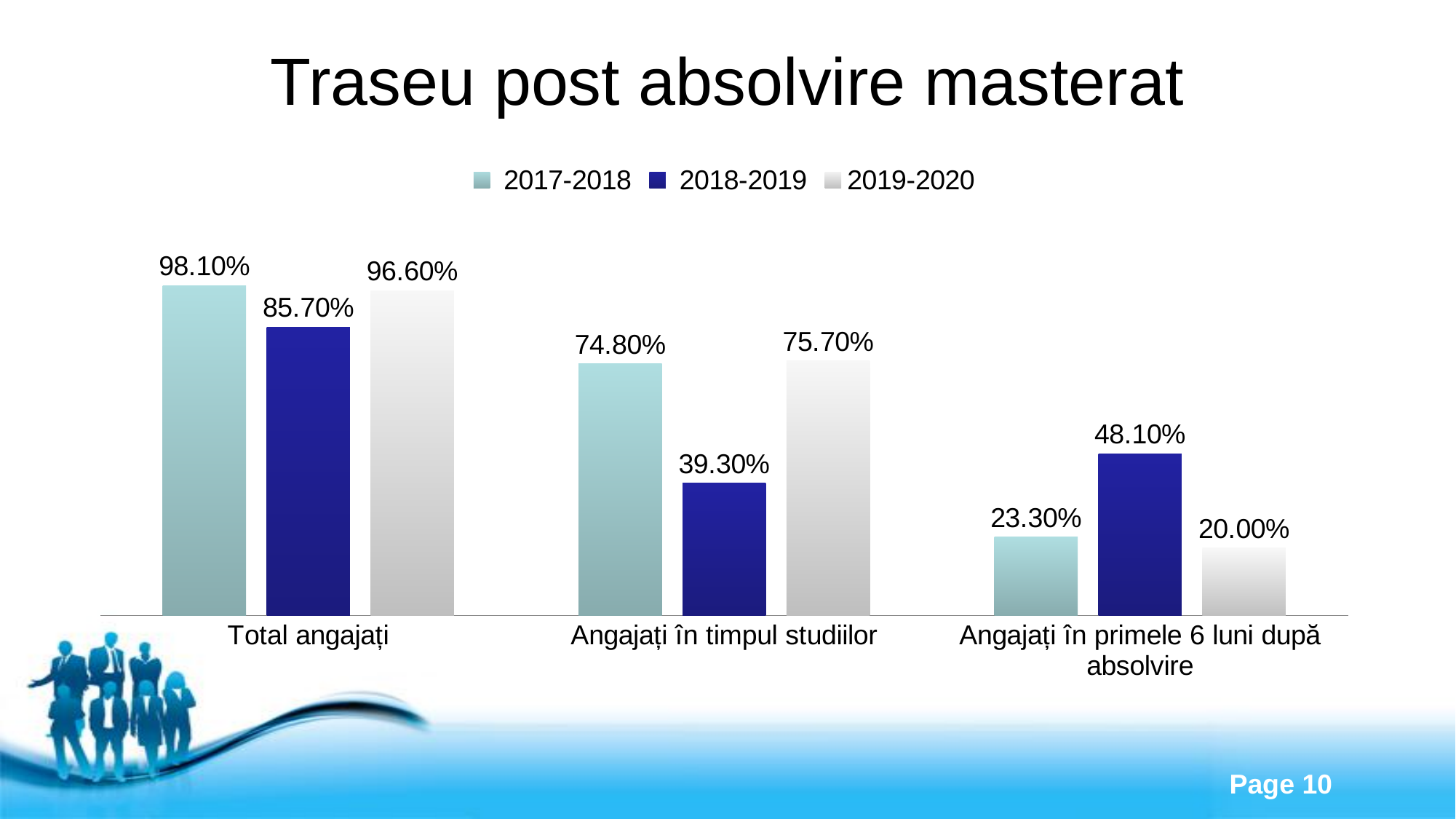
Which series has the lowest value in the "Total angajați" category? 2018-2019 What is the value for 2019-2020 in the "Angajați în primele 6 luni după absolvire" category? 20.00% How many categories are shown on the x axis? 3 How many series does the legend list? 3 What kind of chart is shown on the slide? Bar chart What is the value for 2018-2019 in the "Angajați în timpul studiilor" category? 39.30% What is the difference between the 2017-2018 and 2018-2019 values in the "Angajați în timpul studiilor" category? 35.50% Which series has the highest value in the "Angajați în primele 6 luni după absolvire" category? 2018-2019 What is the title of the slide? Traseu post absolvire masterat Which is larger: the 2017-2018 value or the 2019-2020 value in the "Angajați în timpul studiilor" category? 2019-2020 Which series is shown in dark blue in the legend? 2018-2019 What is the value for 2017-2018 in the "Total angajați" category? 98.10%